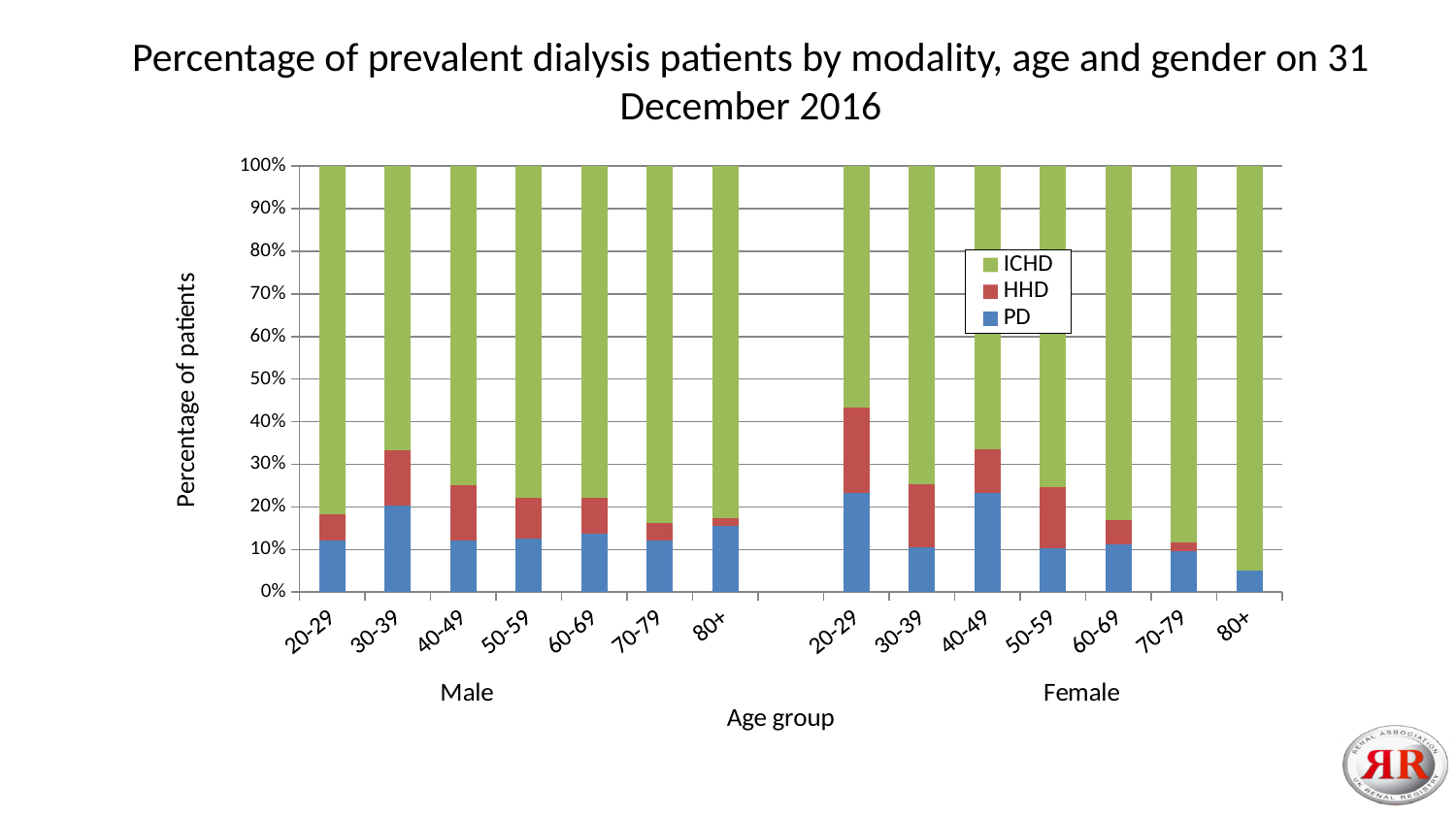
Which colour represents ICHD in the legend? Green Among the Female age groups, which has the largest combined PD and HHD share? 20-29 How many age groups are shown for the Female group? 7 What kind of chart is shown on the slide? Stacked bar chart Among the Male age groups, which has the largest PD share? 30-39 Is the PD value for Female 80+ greater or less than 10%? less How many series does the legend list? 3 How many age-group bars are plotted in total across both genders? 14 Which has the larger PD share: Female 20-29 or Female 30-39? Female 20-29 Among the Female age groups, which has the lowest PD share? 80+ Is the PD value for Female 20-29 greater or less than 20%? greater Is the PD value for Male 30-39 greater or less than 10%? greater